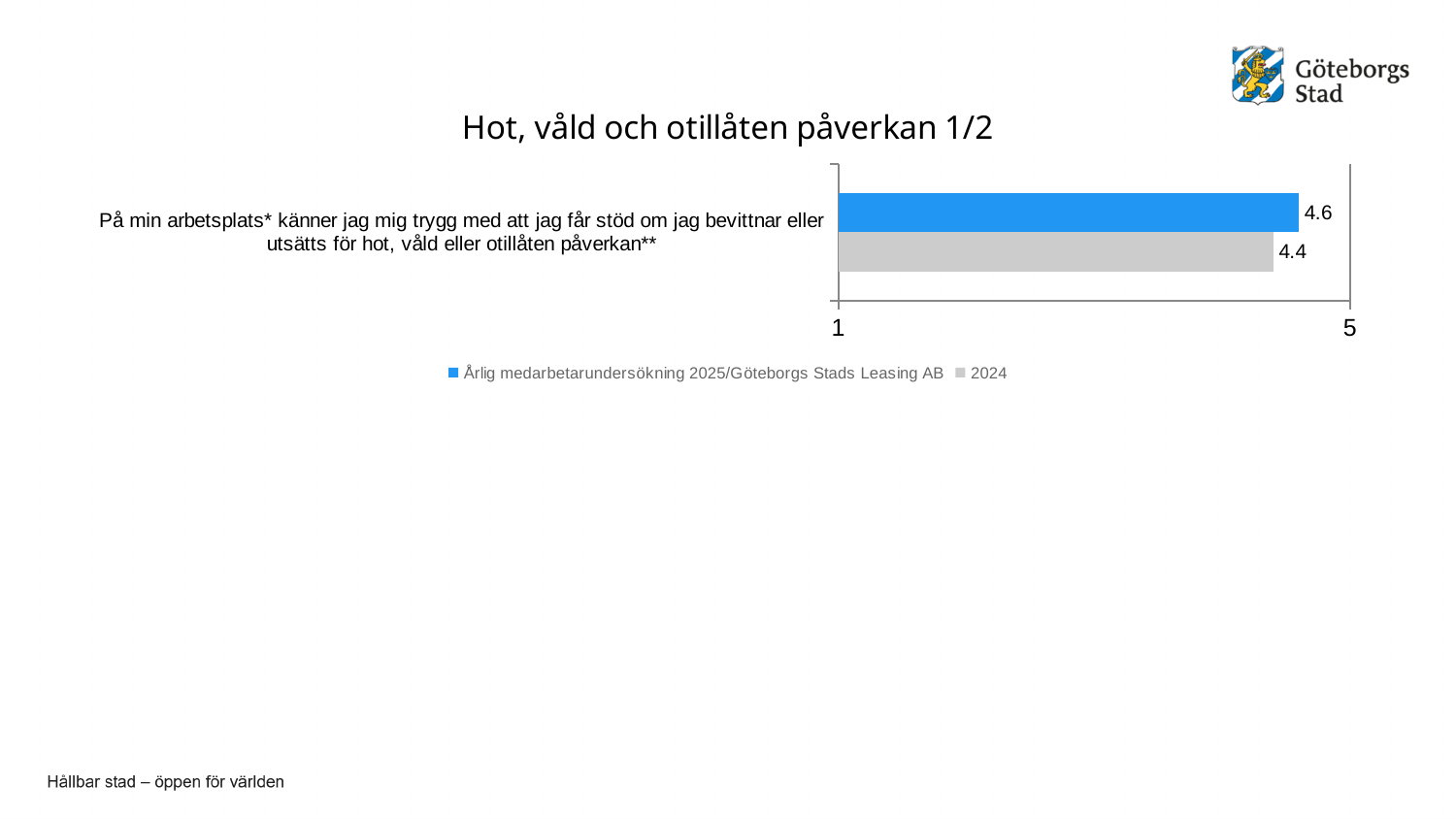
Which series has the higher value, 'Årlig medarbetarundersökning 2025/Göteborgs Stads Leasing AB' or '2024'? Årlig medarbetarundersökning 2025/Göteborgs Stads Leasing AB What is the maximum value shown on the chart's axis? 5 What is the value for the series '2024'? 4.4 What is the title of the slide containing the chart? Hot, våld och otillåten påverkan 1/2 How many series does the legend list? 2 What is the value for the series 'Årlig medarbetarundersökning 2025/Göteborgs Stads Leasing AB'? 4.6 Is the value for 2024 greater or less than 5? less How many categories (statements) are plotted in the chart? 1 What kind of chart is shown on the slide? Bar chart What is the difference between the 2025 value and the 2024 value? 0.2